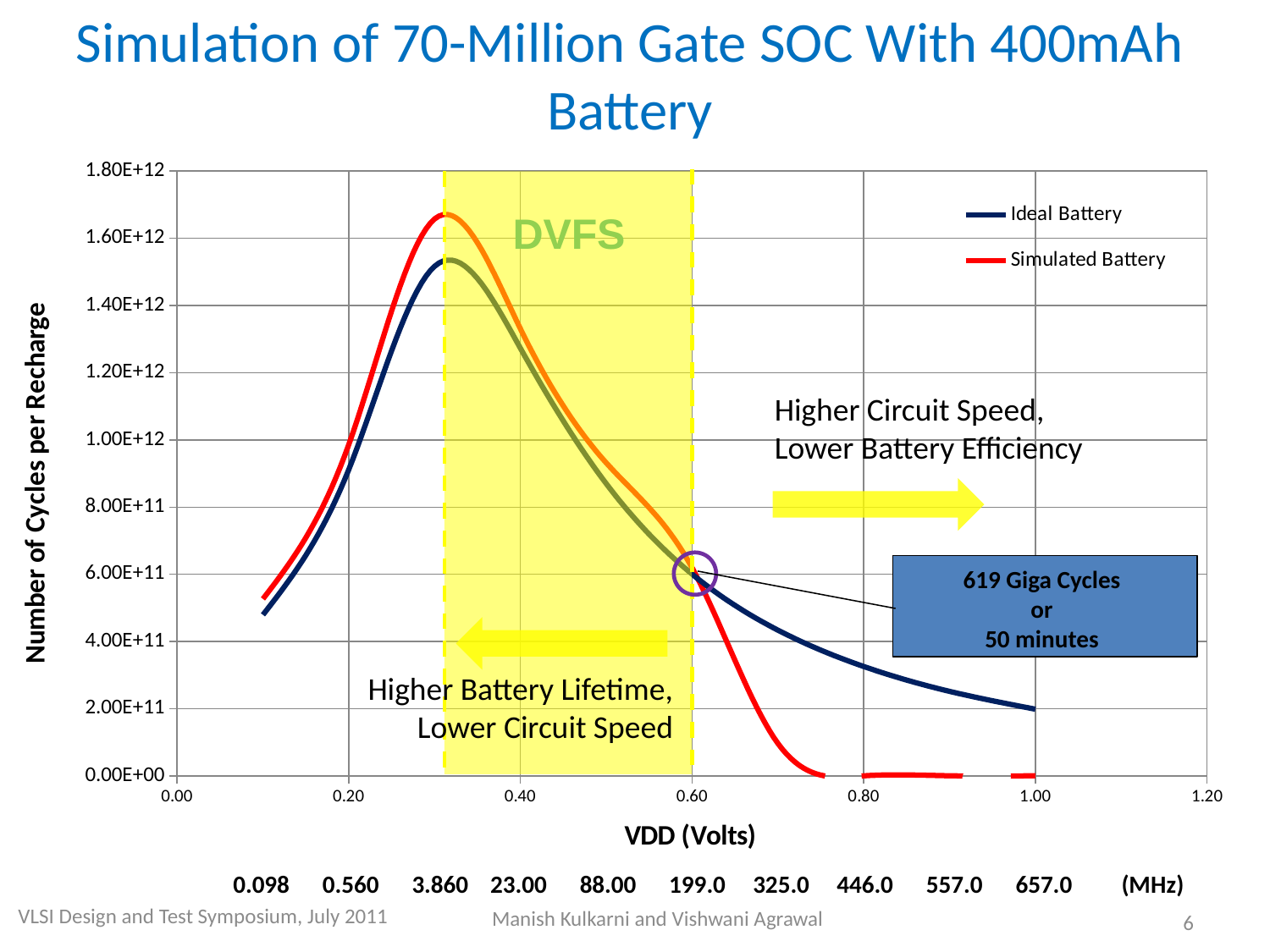
What kind of chart is shown on the slide? line chart Is the peak value of the Simulated Battery curve greater or less than 1.60E+12? greater Between 0.60 and 1.00 volts, does the Ideal Battery curve rise or fall? fall Is the Ideal Battery value at 0.80 volts greater or less than 2.00E+11? greater What value is called out in the blue annotation box at the crossing point of the two curves? 619 Giga Cycles or 50 minutes How many series does the legend list? 2 Is the peak value of the Ideal Battery curve greater or less than 1.60E+12? less At 0.80 volts, which series has the higher number of cycles per recharge? Ideal Battery Which series reaches the higher peak number of cycles per recharge? Simulated Battery At 0.30 volts, which series has the higher number of cycles per recharge? Simulated Battery What are the two series named in the legend? Ideal Battery and Simulated Battery